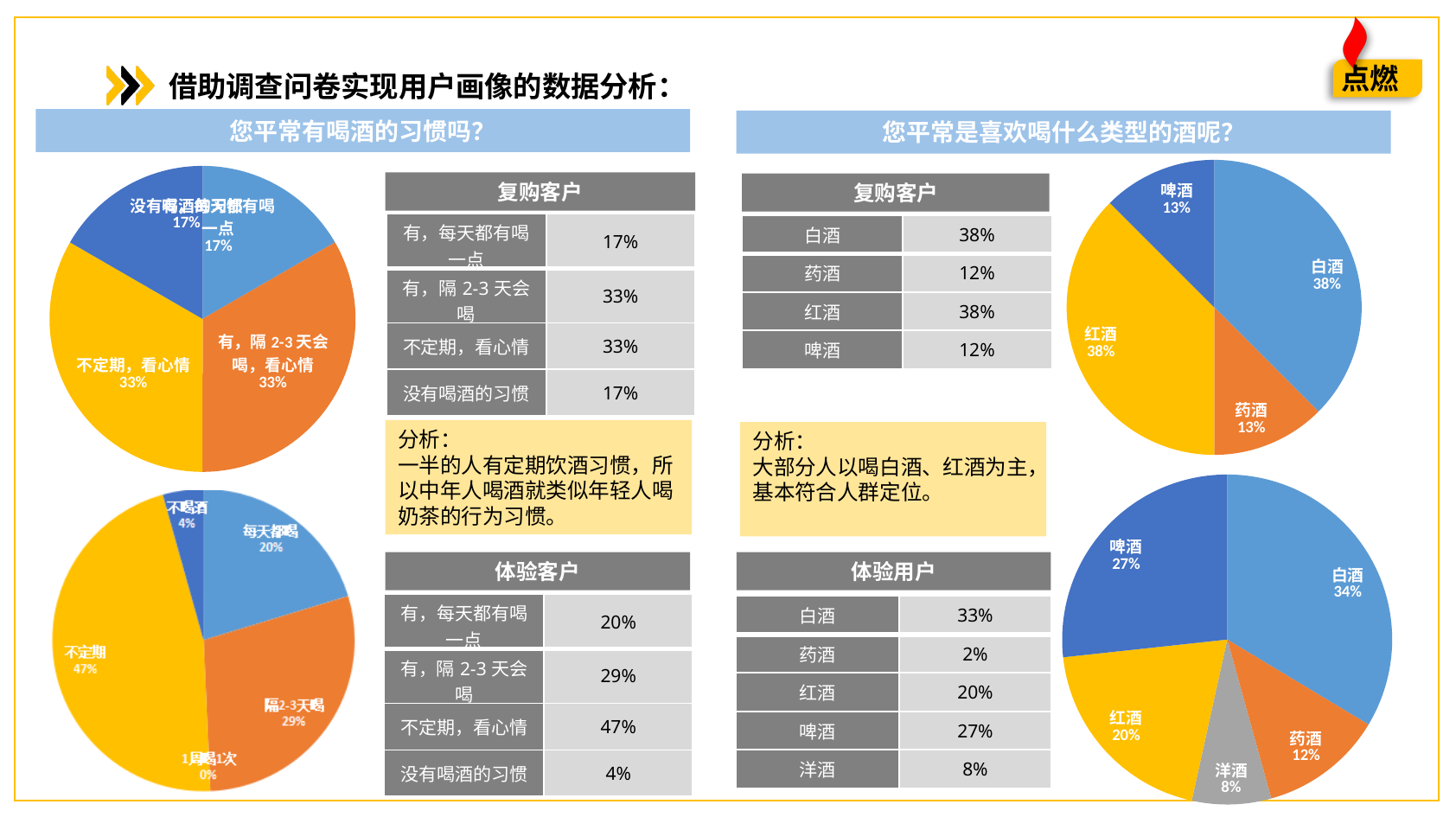
In the top-left pie chart, what is the share for 不定期，看心情? 33% What type of chart is used in the bottom-left of the slide? Pie chart In the bottom-left pie chart, what is the difference between the shares for 不定期 and 每天都喝? 27% In the bottom-right pie chart, what is the share for 啤酒? 27% In the bottom-right pie chart, which is larger, the slice for 红酒 or the slice for 药酒? 红酒 In the bottom-right pie chart, which category has the smallest slice? 洋酒 In the top-right pie chart, what is the difference between the shares for 白酒 and 药酒? 25% In the bottom-left pie chart, which category has the largest slice? 不定期 In the bottom-left pie chart, what is the share for 隔2-3天喝? 29% How many slices are labelled in the bottom-right pie chart? 5 In the top-right pie chart, what is the share for 啤酒? 13% In the bottom-left pie chart, what is the share for 不定期? 47%